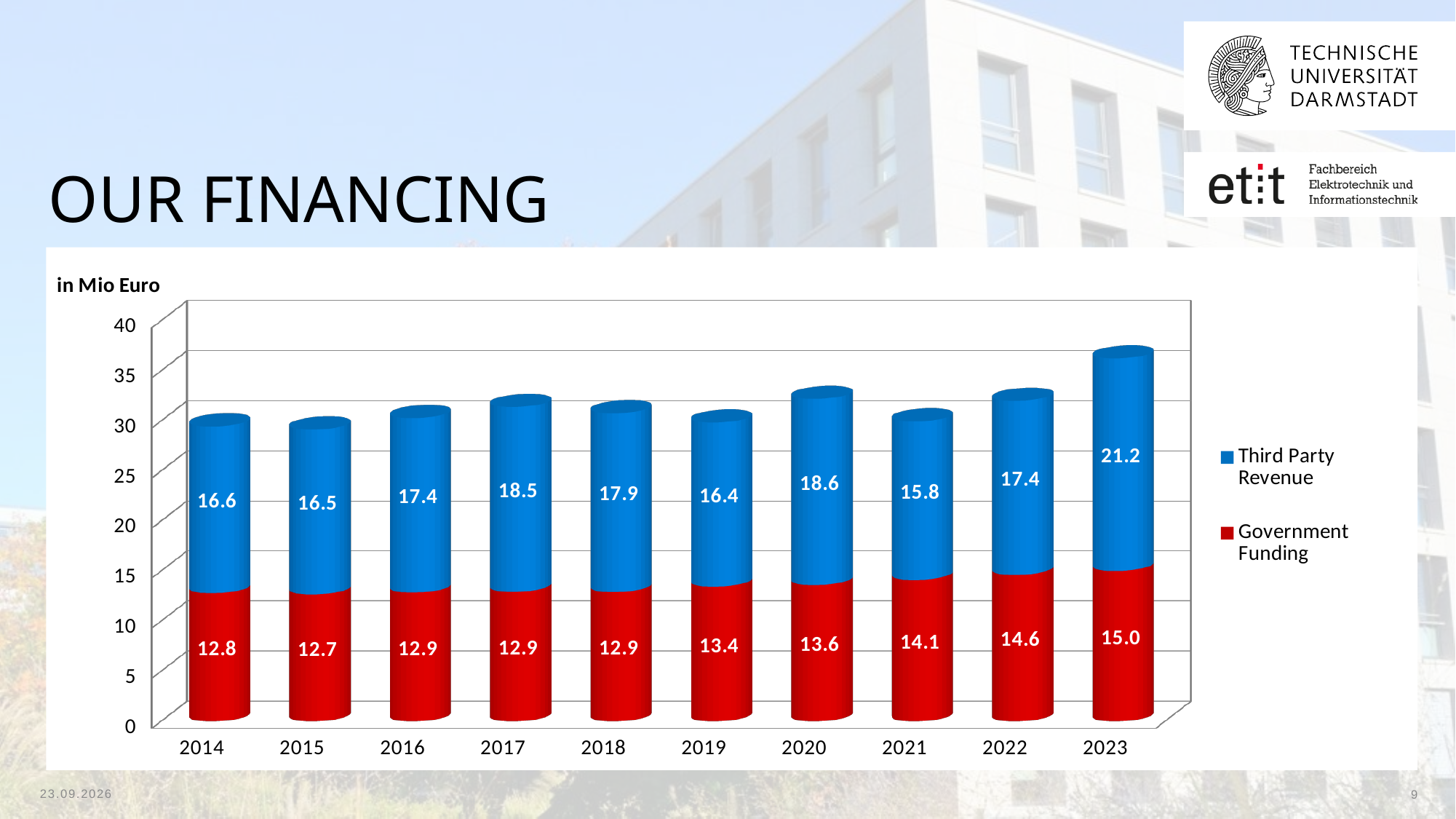
What kind of chart is shown on the slide? Stacked bar chart What is the total of the stacked bar for 2023? 36.2 Which is larger in 2021: Third Party Revenue or Government Funding? Third Party Revenue How many years are shown on the x axis? 10 What is the Third Party Revenue value for 2019? 16.4 Which year has the lowest Government Funding? 2015 What is the difference between Third Party Revenue and Government Funding in 2020? 5.0 What is the Third Party Revenue value for 2023? 21.2 How many series does the legend list? 2 What is the Government Funding value for 2014? 12.8 What is the total of the stacked bar for 2015? 29.2 Which year has the highest Third Party Revenue? 2023